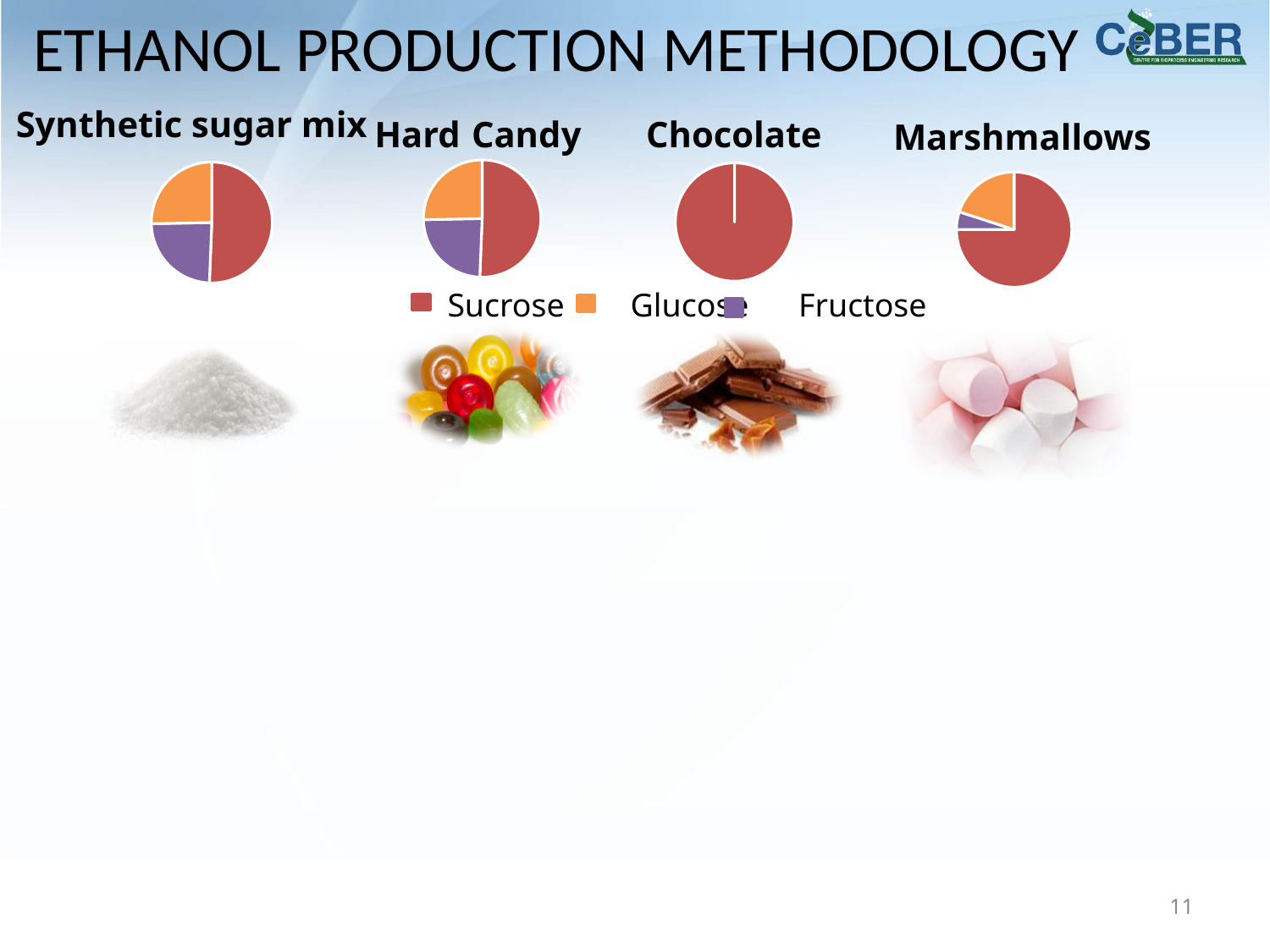
In the Marshmallows pie chart, which is larger: the Glucose share or the Fructose share? Glucose In the Chocolate pie chart, which sugar has the largest share? Sucrose In the Marshmallows pie chart, which sugar has the largest share? Sucrose In the Hard Candy pie chart, which is larger: the Sucrose share or the Glucose share? Sucrose In the Hard Candy pie chart, which sugar has the largest share? Sucrose How many pie charts are shown on the slide? 4 Which colour represents Fructose in the pie charts? Purple What is the title of the pie chart on the far right of the slide? Marshmallows What kind of chart is used for the Synthetic sugar mix? Pie chart How many entries does the shared legend list? 3 In the Marshmallows pie chart, which sugar has the smallest share? Fructose